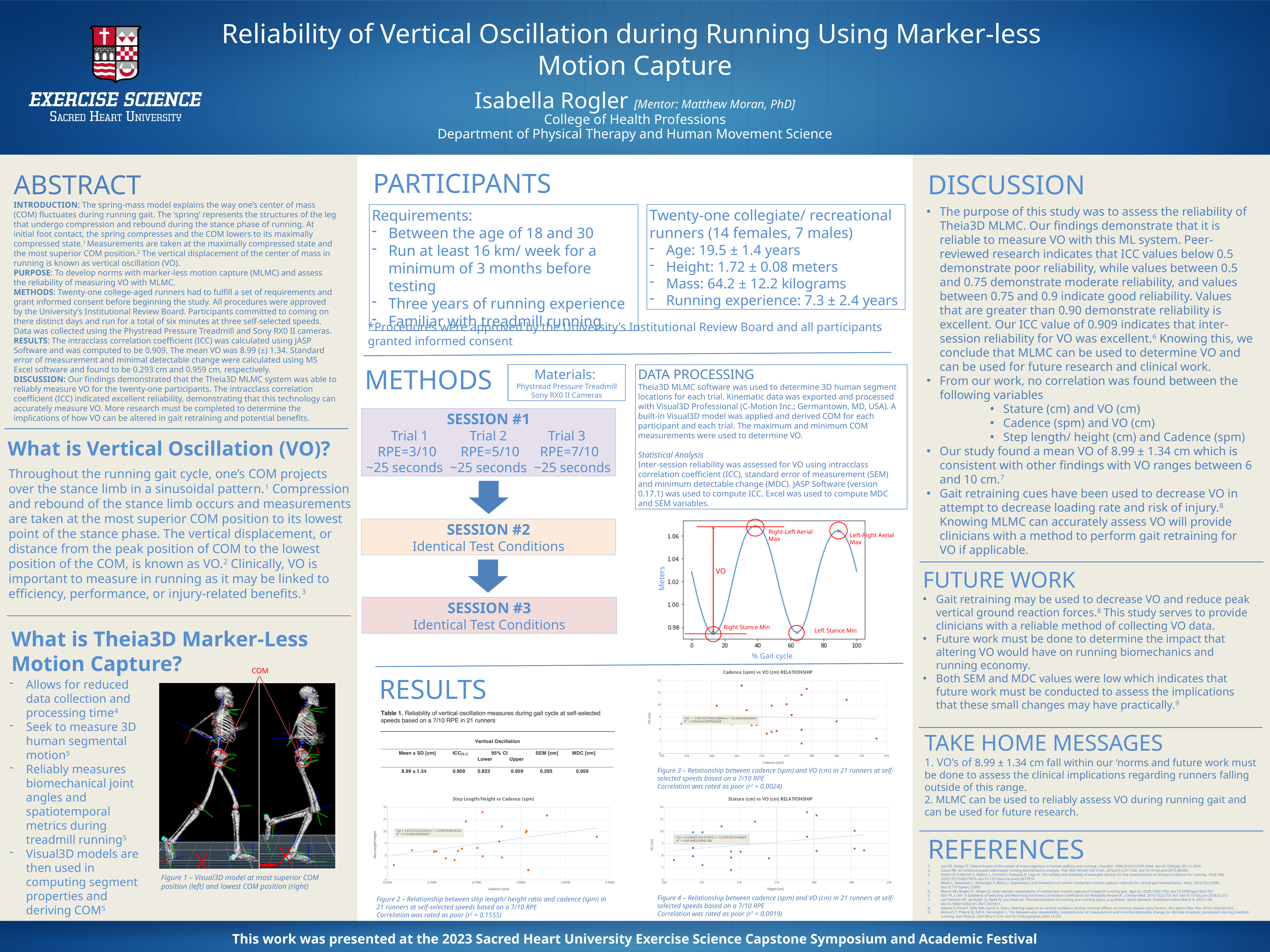
According to its caption, how many runners' data are plotted in the 'Stature (cm) vs VO (cm) RELATIONSHIP' chart? 21 In the '% Gait cycle' line chart, is the value at the point labelled 'Right Stance Min' greater or less than 1.00? less In the '% Gait cycle' line chart, how many aerial maxima are circled and labelled? 2 In the '% Gait cycle' line chart, which is lower: the point labelled 'Right Stance Min' or the point labelled 'Right-Left Aerial Max'? Right Stance Min According to the caption of Figure 3, what r² value was reported for the 'Cadence (spm) vs VO (cm) RELATIONSHIP' chart? 0.0024 In the '% Gait cycle' line chart, what is the label on the y-axis? Meters In the '% Gait cycle' line chart, is the value at the point labelled 'Right-Left Aerial Max' greater or less than 1.04? greater In the 'Step Length/Height vs Cadence (spm)' chart, does the dotted trend line rise or fall from left to right? rises In the 'Cadence (spm) vs VO (cm) RELATIONSHIP' chart, is the highest plotted VO value greater or less than 11? greater What kind of chart is the chart with 'Meters' on the y-axis and '% Gait cycle' on the x-axis? line chart What kind of chart is the 'Step Length/Height vs Cadence (spm)' chart? scatter chart